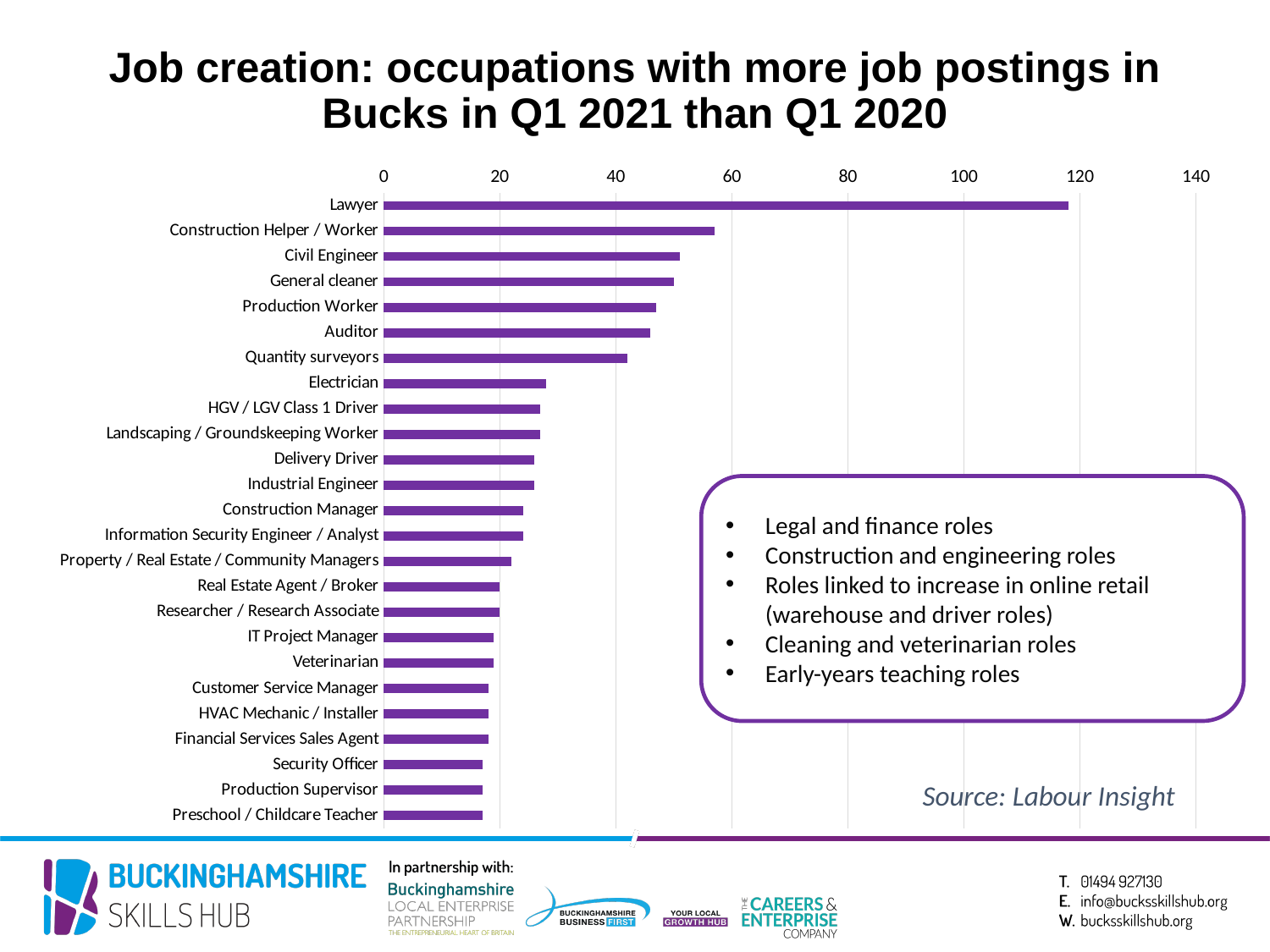
Do the bar values increase or decrease going from the top of the chart to the bottom? decrease Is the value for Electrician greater or less than 40? less Is the value for Construction Helper / Worker greater or less than 60? less How many occupations are listed in the chart? 25 What kind of chart is shown on the slide? bar chart Is the value for Civil Engineer greater or less than 40? greater Which has a larger value, Construction Helper / Worker or Electrician? Construction Helper / Worker Which occupation has the highest value in the chart? Lawyer What source is cited for the chart data? Labour Insight Which has a larger value, Lawyer or Civil Engineer? Lawyer